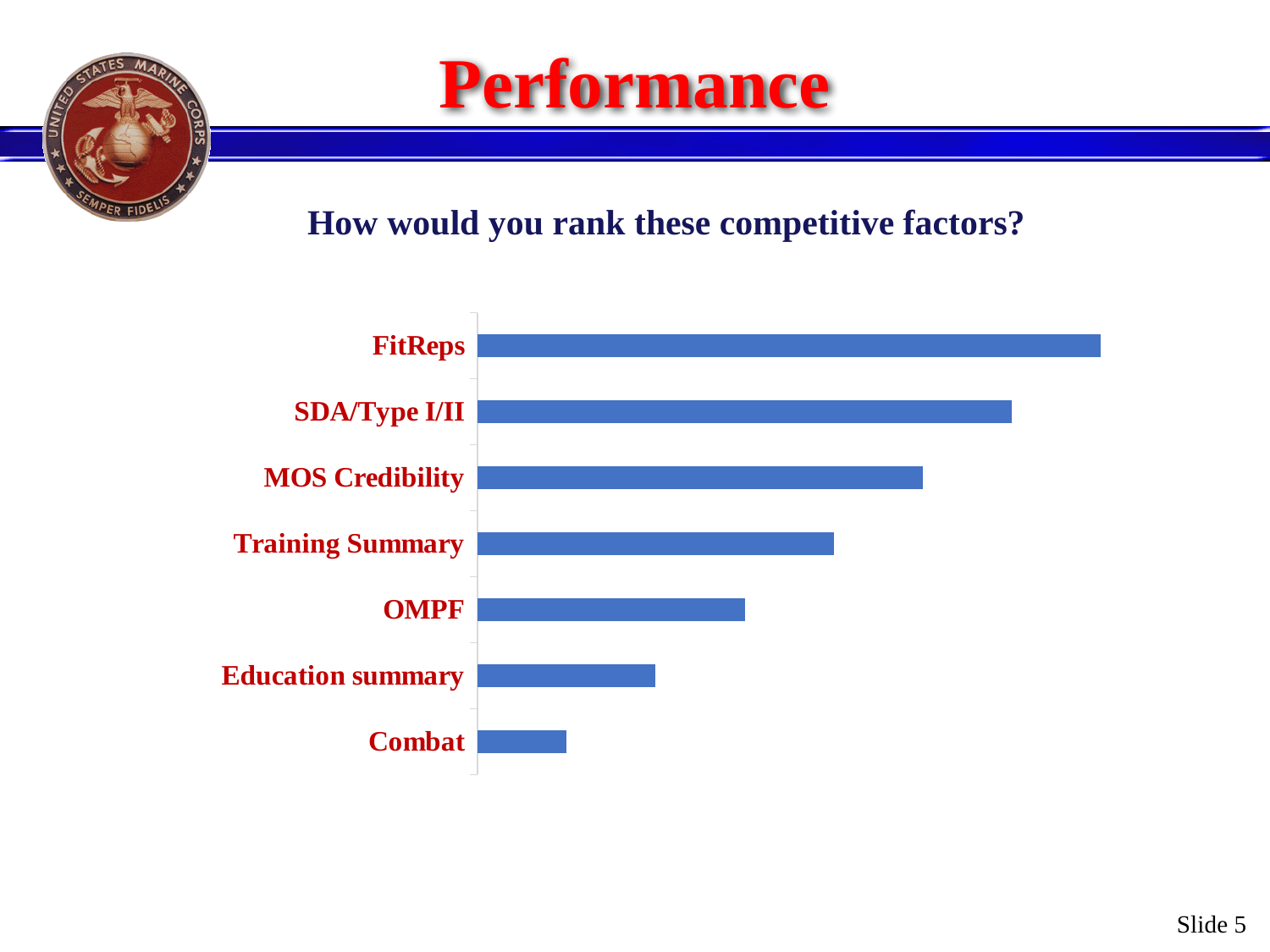
What question is posed above the chart? How would you rank these competitive factors? Which has the larger value, MOS Credibility or OMPF? MOS Credibility Which category has the shortest bar? Combat How many categories (bars) does the chart show? 7 Which has the larger value, Education summary or Training Summary? Training Summary Do the bar lengths increase or decrease going from the top category to the bottom category? Decrease What kind of chart is shown on the slide? Bar chart Which category is ranked second highest in the chart? SDA/Type I/II What colour are the bars in the chart? Blue Which has the larger value, SDA/Type I/II or FitReps? FitReps Which category has the longest bar? FitReps